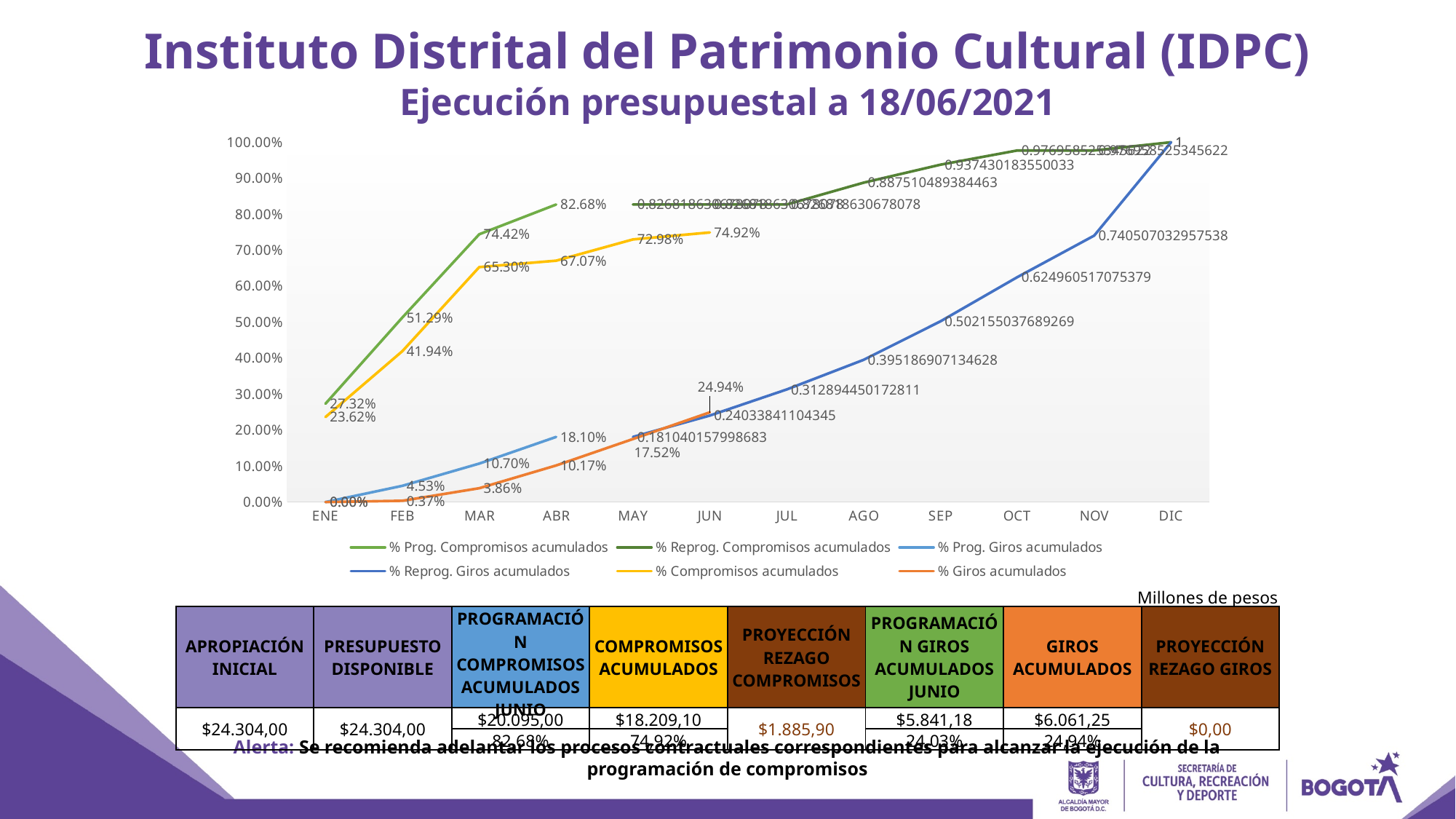
What kind of chart is shown on the slide? line chart What is the difference between % Prog. Compromisos acumulados and % Compromisos acumulados in MAR? 9.12% What is the value of % Prog. Compromisos acumulados in ABR? 82.68% What is the value of % Giros acumulados in JUN? 24.94% Which is larger in ABR: % Prog. Giros acumulados or % Giros acumulados? % Prog. Giros acumulados Does % Giros acumulados rise or fall from ENE to JUN? rise What is the value of % Compromisos acumulados in JUN? 74.92% Is the value of % Reprog. Giros acumulados in SEP greater or less than 40.00%? greater What is the value of % Prog. Giros acumulados in MAR? 10.70% Which series reaches the lowest value in FEB? % Giros acumulados How many months are shown along the x axis of the chart? 12 How many series does the chart legend list? 6